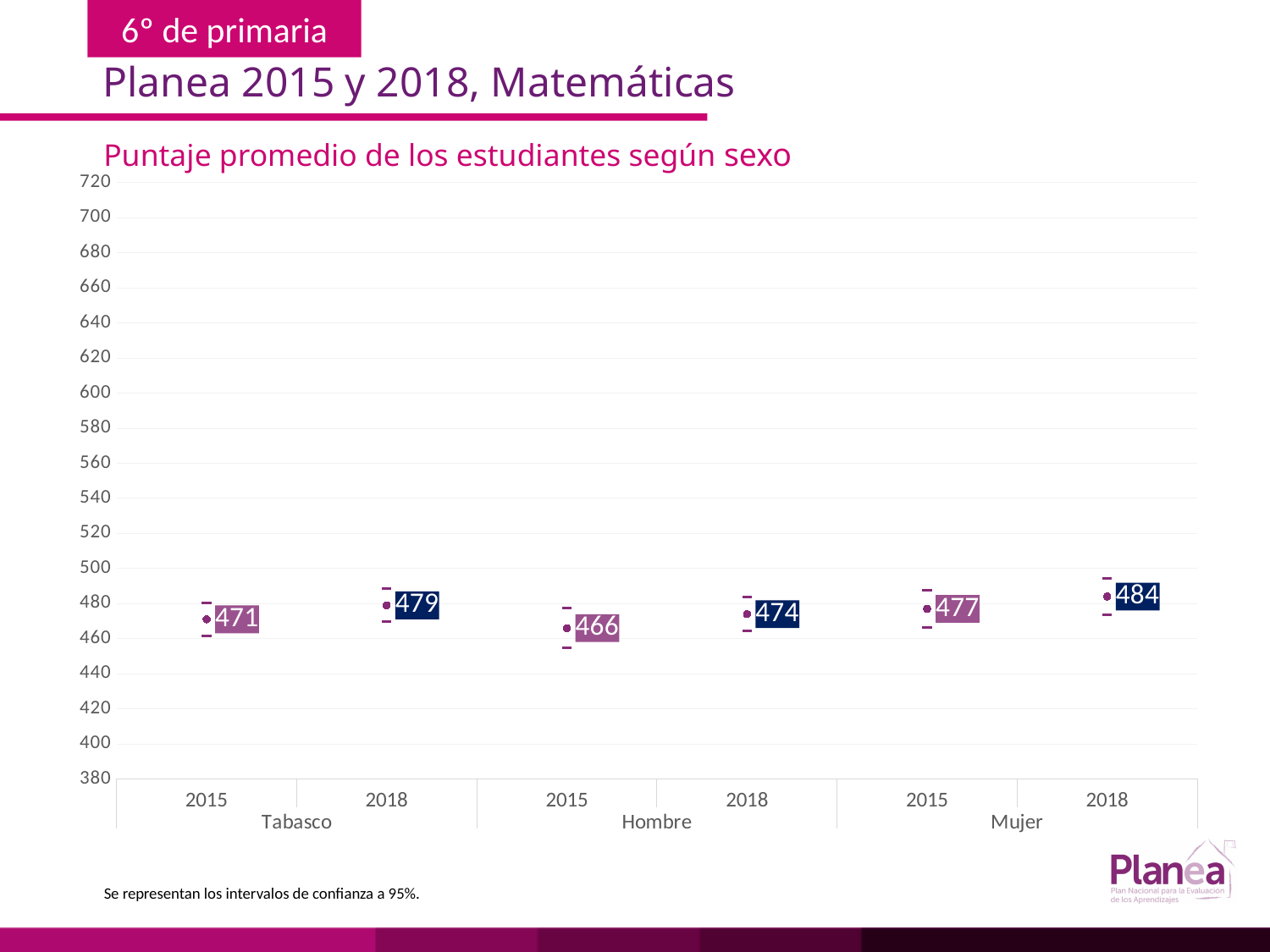
Which is larger, the Mujer score in 2015 or the Hombre score in 2015? Mujer 2015 Which group and year has the lowest average score? Hombre 2015 By how many points did the average score for Tabasco change from 2015 to 2018? 8 What is the average score for Mujer in 2018? 484 What is the average score for Tabasco in 2015? 471 Do the average scores rise or fall from 2015 to 2018 for each group? rise Is the average score for Mujer in 2018 greater or less than 500? less How many data points are plotted on the chart? 6 What is the average score for Hombre in 2015? 466 What is the difference between the Mujer and Hombre average scores in 2018? 10 Which group and year has the highest average score? Mujer 2018 What is the average score for Hombre in 2018? 474